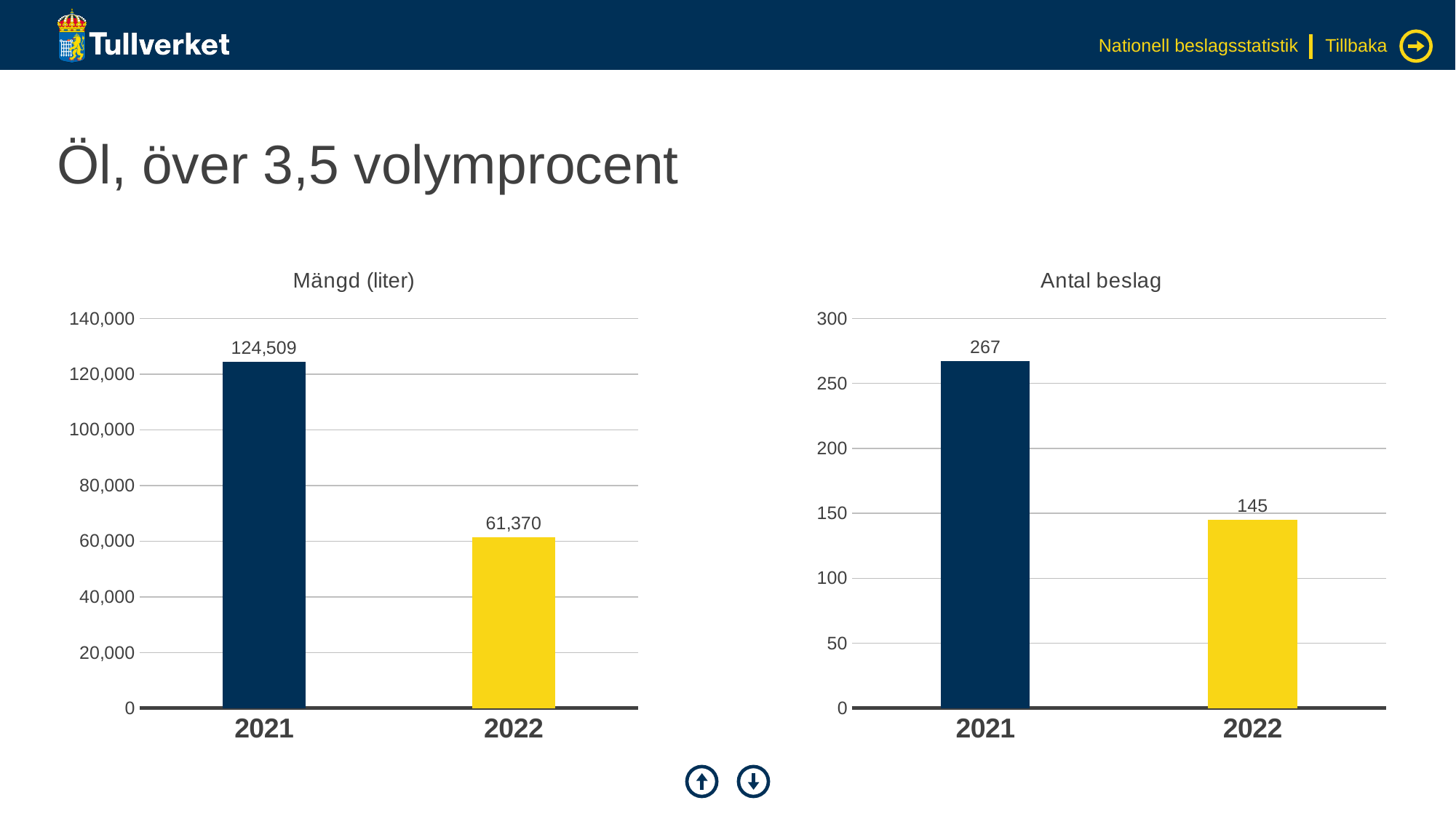
In the 'Mängd (liter)' chart, what is the difference between the 2021 and 2022 values? 63,139 How many categories are shown on the x axis of the 'Mängd (liter)' chart? 2 In the 'Mängd (liter)' chart, do the values rise or fall from 2021 to 2022? fall In the 'Mängd (liter)' chart, what is the value for 2022? 61,370 What kind of chart is the 'Antal beslag' chart? bar chart In the 'Antal beslag' chart, what is the value for 2021? 267 In the 'Antal beslag' chart, what is the value for 2022? 145 In the 'Antal beslag' chart, is the value for 2022 greater or less than 150? less In the 'Antal beslag' chart, what is the difference between the 2021 and 2022 values? 122 In the 'Antal beslag' chart, which year has the lowest value? 2022 In the 'Mängd (liter)' chart, which year has the highest value? 2021 In the 'Mängd (liter)' chart, what is the value for 2021? 124,509